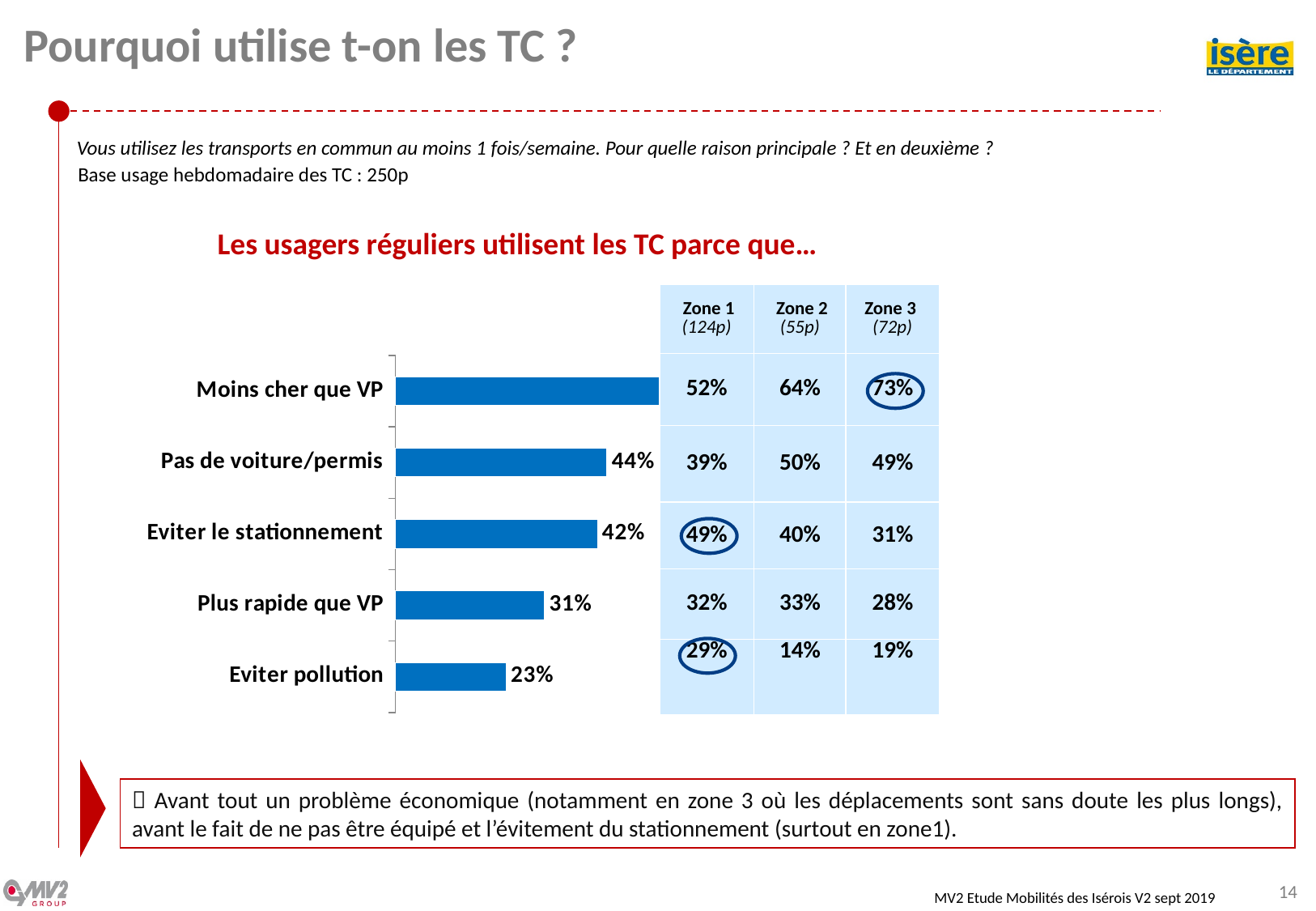
What is the difference in percentage points between "Eviter le stationnement" and "Plus rapide que VP"? 11 What is the value for "Pas de voiture/permis" in the bar chart? 44% What is the title shown above the chart? Les usagers réguliers utilisent les TC parce que… How many categories are shown in the bar chart? 5 What is the value for "Eviter pollution" in the bar chart? 23% Which category has the lowest value in the bar chart? Eviter pollution What is the difference in percentage points between "Pas de voiture/permis" and "Eviter pollution"? 21 What is the value for "Eviter le stationnement" in the bar chart? 42% What kind of chart is shown on the slide? Bar chart Which category has the longest bar in the chart? Moins cher que VP What is the value for "Plus rapide que VP" in the bar chart? 31% Which is larger in the bar chart: "Plus rapide que VP" or "Eviter pollution"? Plus rapide que VP